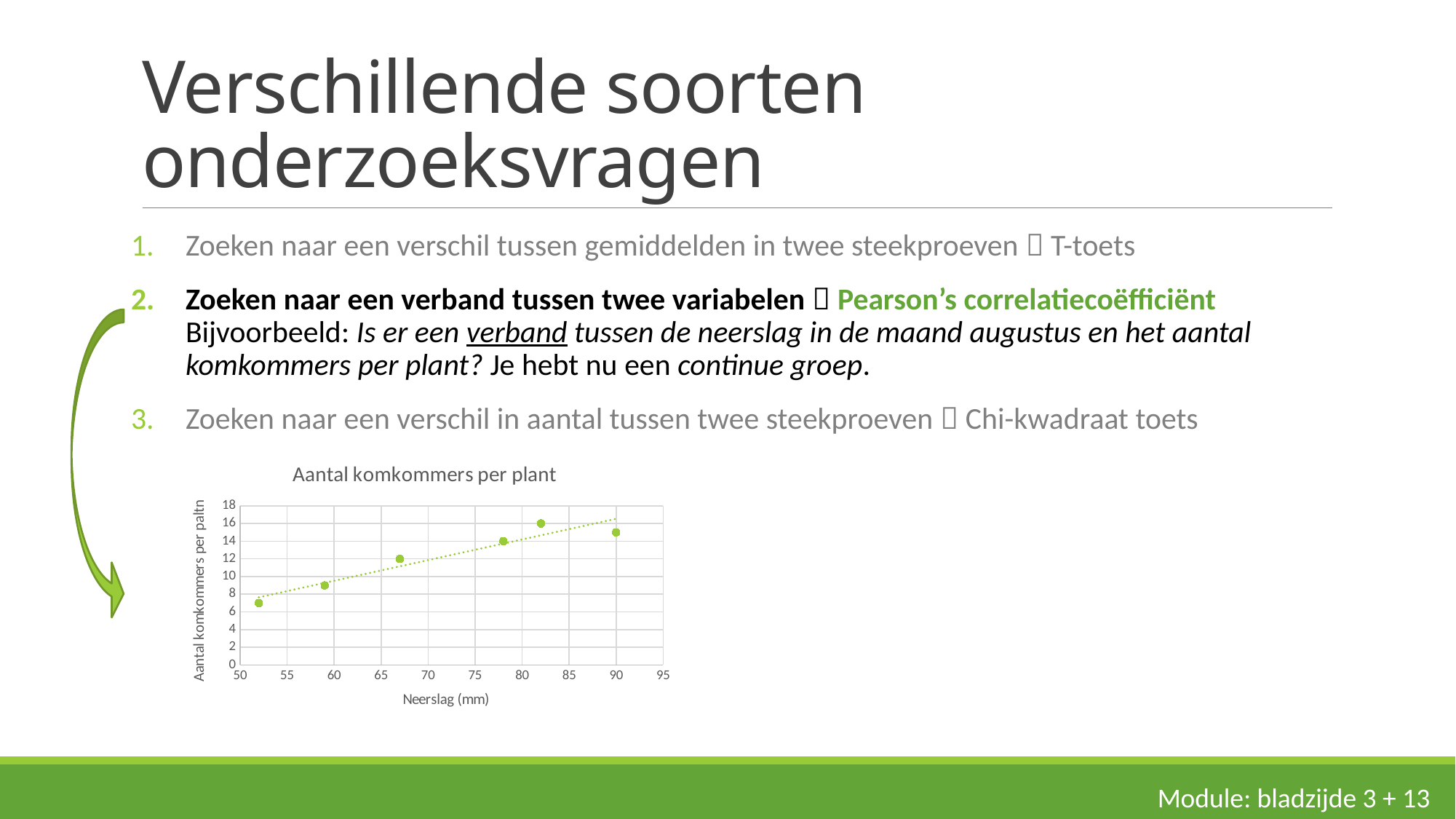
What is the maximum value shown on the y axis of the chart? 18 What is the title of the chart? Aantal komkommers per plant Is the value for the point at about 59 mm Neerslag greater or less than 10? less Which point has the lowest number of komkommers per plant? the leftmost point, at about 52 mm Neerslag Is the value for the point at about 82 mm Neerslag greater or less than 14? greater How many data points are plotted in the chart? 6 Which point has the highest number of komkommers per plant: the one at about 82 mm or the one at 90 mm Neerslag? the one at about 82 mm Is the value for the leftmost point (around 52 mm Neerslag) greater or less than 8? less What kind of chart is shown on the slide? scatter chart Do the values generally rise or fall as Neerslag (mm) increases along the x axis? rise What is the label of the x axis of the chart? Neerslag (mm)